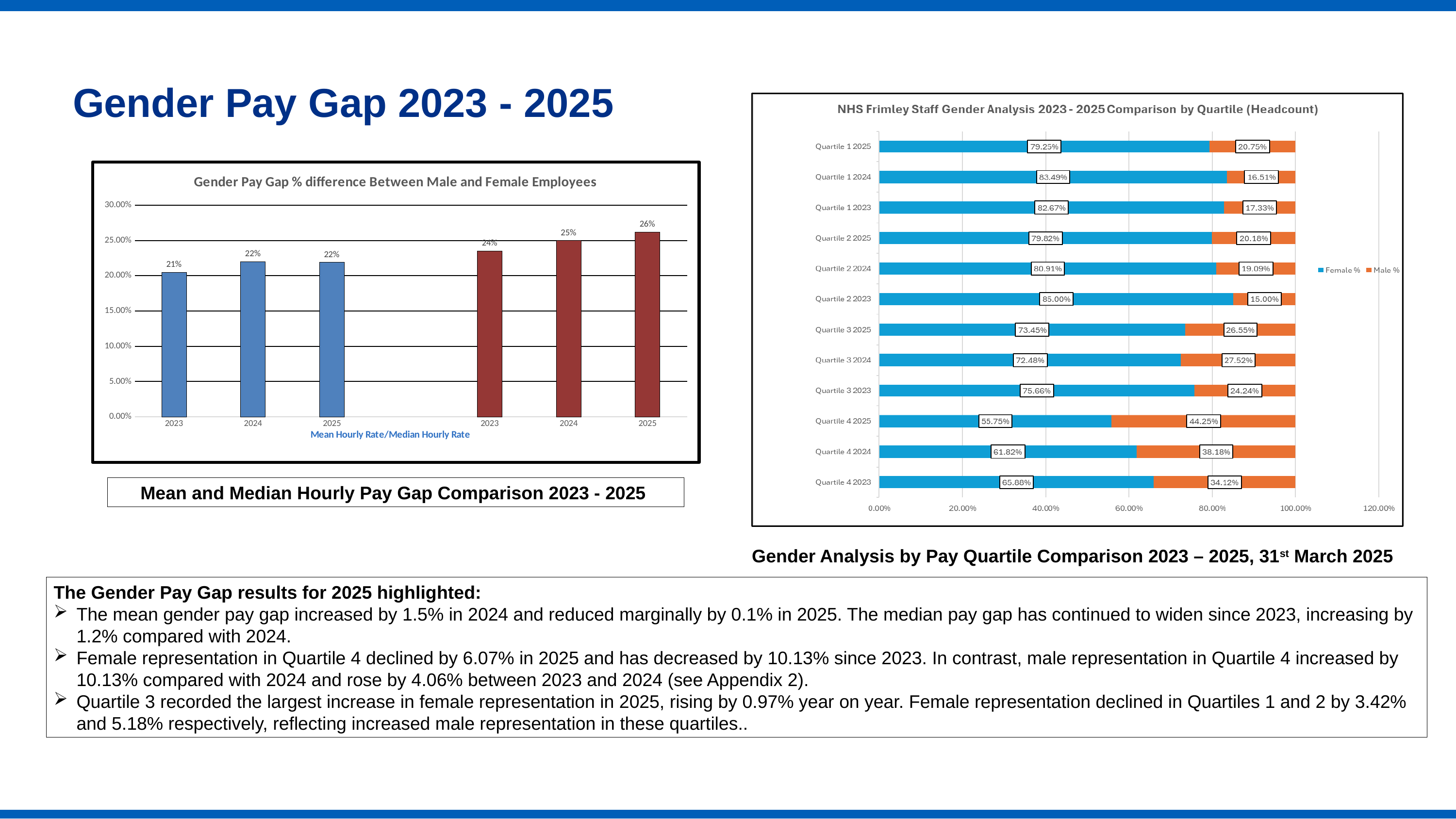
In the right chart 'NHS Frimley Staff Gender Analysis 2023 - 2025 Comparison by Quartile (Headcount)', which category has the lowest Female %? Quartile 4 2025 In the left chart 'Gender Pay Gap % difference Between Male and Female Employees', what is the value of the blue bar for 2023? 21% In the left chart 'Gender Pay Gap % difference Between Male and Female Employees', how many bars are plotted? 6 In the left chart 'Gender Pay Gap % difference Between Male and Female Employees', which bar has the highest value? Red bar for 2025 In the left chart 'Gender Pay Gap % difference Between Male and Female Employees', do the red bars rise or fall from 2023 to 2025? Rise What kind of chart is the right chart 'NHS Frimley Staff Gender Analysis 2023 - 2025 Comparison by Quartile (Headcount)'? Stacked bar chart In the right chart 'NHS Frimley Staff Gender Analysis 2023 - 2025 Comparison by Quartile (Headcount)', how many series does the legend list? 2 In the right chart 'NHS Frimley Staff Gender Analysis 2023 - 2025 Comparison by Quartile (Headcount)', what is the Female % for Quartile 4 2025? 55.75% In the left chart 'Gender Pay Gap % difference Between Male and Female Employees', what is the difference between the red bar for 2025 and the blue bar for 2025? 4% In the right chart 'NHS Frimley Staff Gender Analysis 2023 - 2025 Comparison by Quartile (Headcount)', what is the Male % for Quartile 2 2023? 15.00% In the right chart 'NHS Frimley Staff Gender Analysis 2023 - 2025 Comparison by Quartile (Headcount)', which category has the highest Female %? Quartile 2 2023 In the left chart 'Gender Pay Gap % difference Between Male and Female Employees', what is the value of the red bar for 2025? 26%